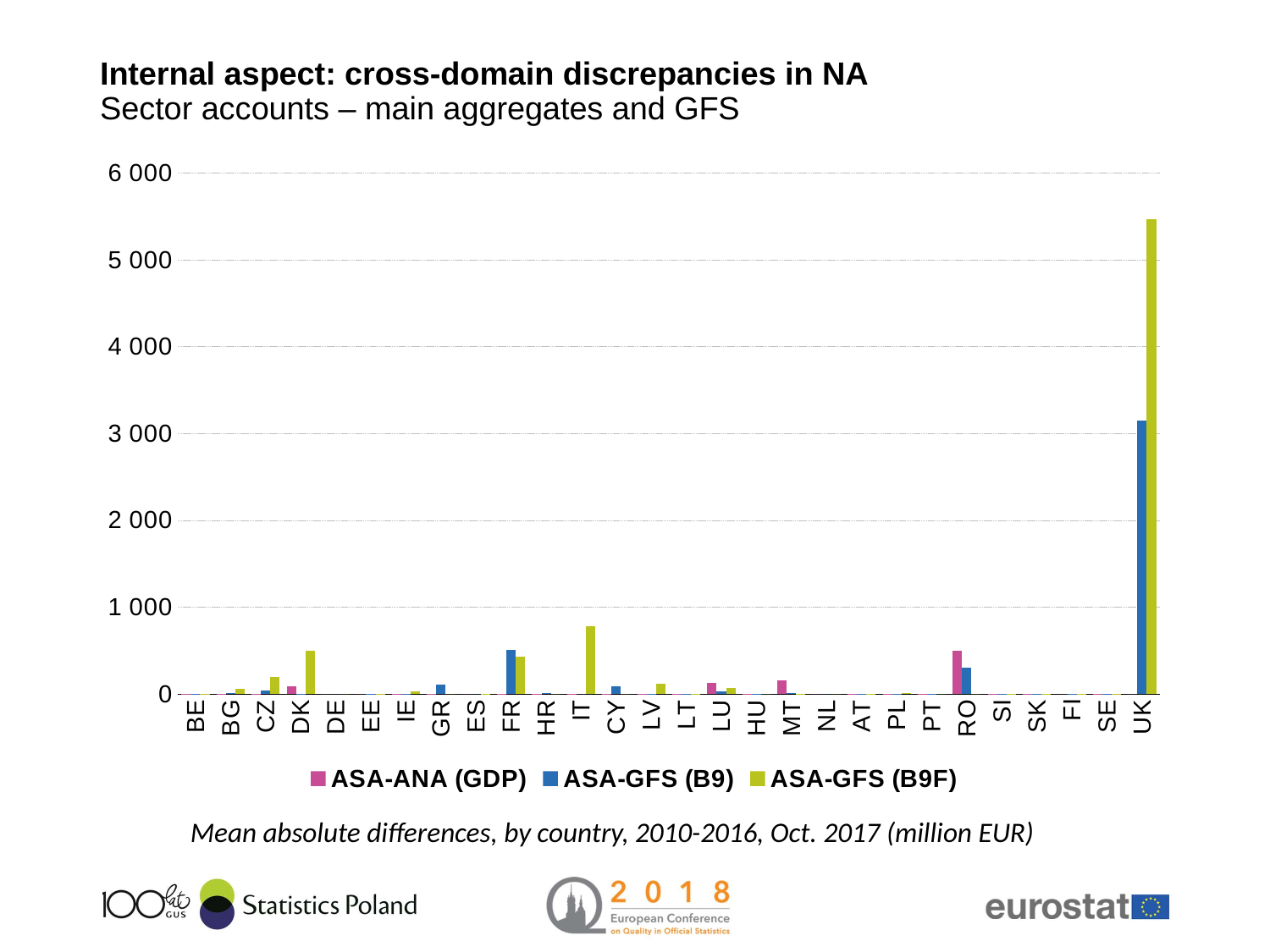
For UK, which series has the larger value: ASA-GFS (B9F) or ASA-GFS (B9)? ASA-GFS (B9F) Is the ASA-GFS (B9F) value for UK greater or less than 5 000? greater Is the ASA-GFS (B9) value for UK greater or less than 3 000? greater Which country has the highest value for the ASA-GFS (B9F) series? UK How many series does the legend list? 3 Which country has the highest value for the ASA-ANA (GDP) series? RO Which is larger: the ASA-GFS (B9F) value for IT or the ASA-GFS (B9F) value for DK? IT Is the ASA-GFS (B9F) value for IT greater or less than 1 000? less Which country has the highest value for the ASA-GFS (B9) series? UK What kind of chart is shown on the slide? bar chart What unit are the values in, according to the caption below the chart? million EUR How many countries are shown on the x axis? 28